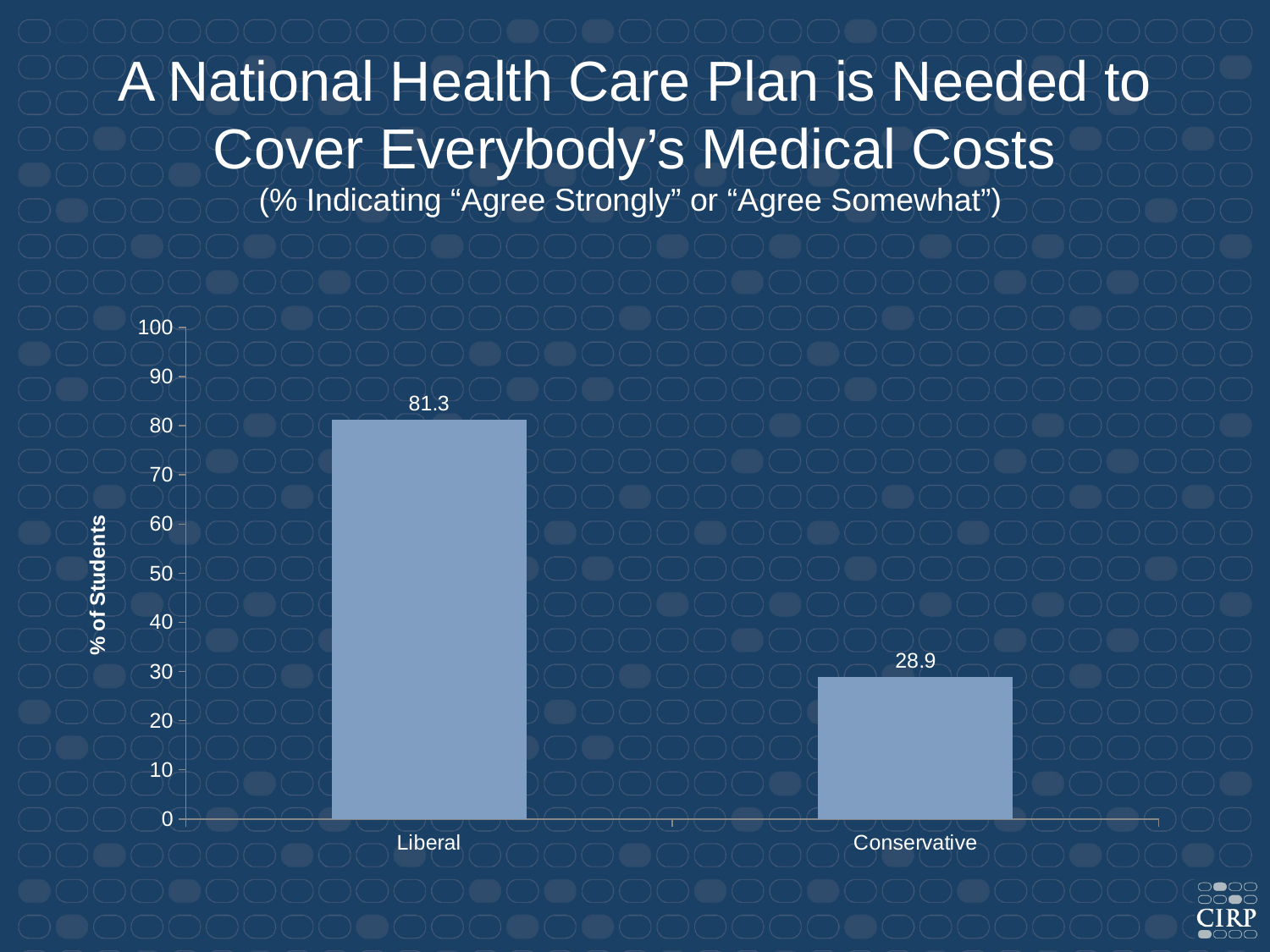
Which category has the lowest value? Conservative What is the difference between the values for Liberal and Conservative? 52.4 Which category has the highest value? Liberal What kind of chart is shown on the slide? bar chart Is the value for Liberal greater or less than 80? greater What is the value for Liberal? 81.3 What is the label of the y axis? % of Students What is the value for Conservative? 28.9 Which is larger, the value for Liberal or the value for Conservative? Liberal What is the maximum value shown on the y axis? 100 Is the value for Conservative greater or less than 30? less How many categories are shown on the x axis? 2